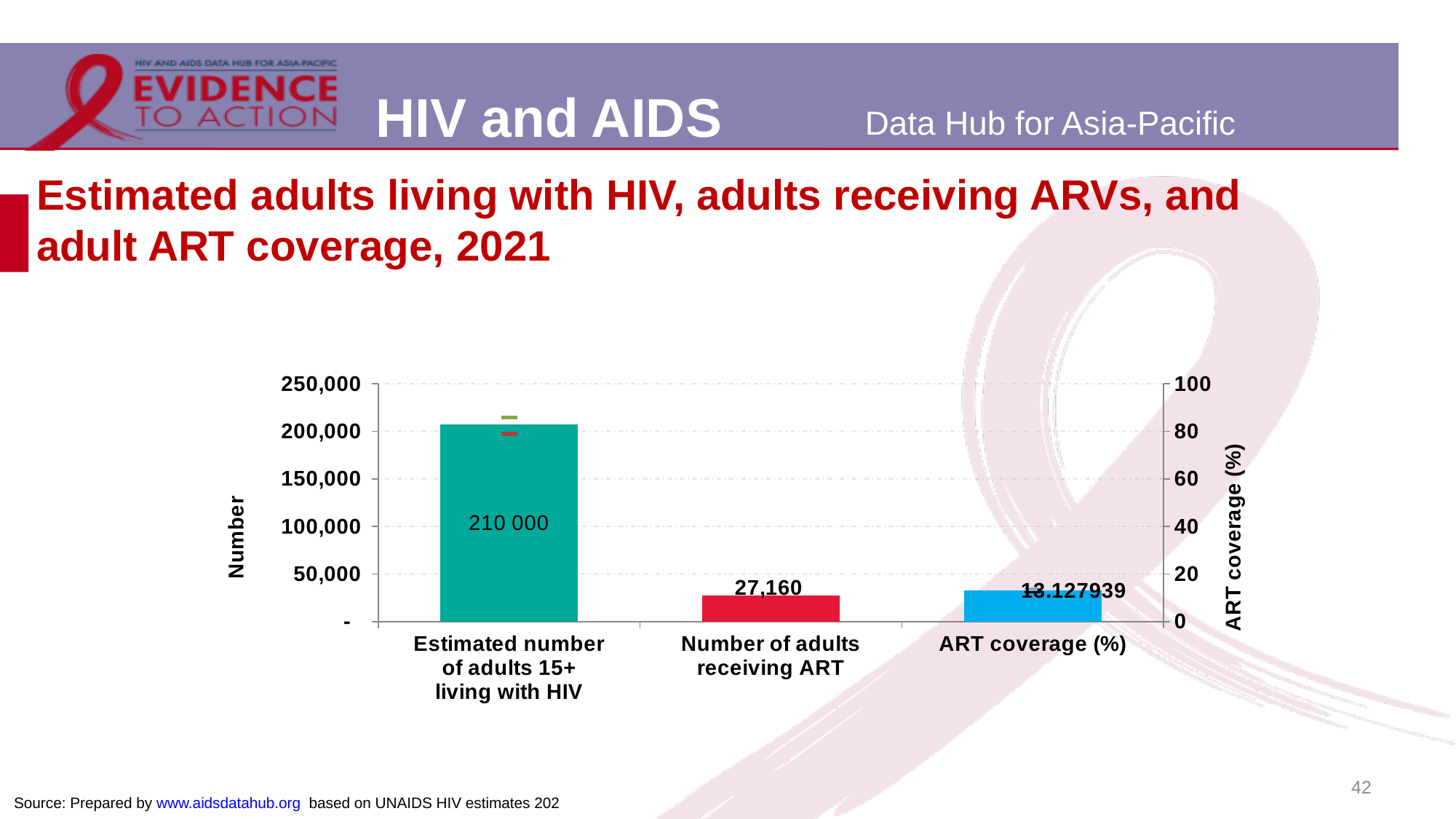
What is the title of the right vertical axis of the chart? ART coverage (%) What is the difference between the estimated number of adults 15+ living with HIV and the number of adults receiving ART? 182,840 How many categories are plotted on the chart? 3 Which category has the shortest bar on the chart? Number of adults receiving ART What is the estimated number of adults 15+ living with HIV shown on the chart? 210 000 What kind of chart is shown on the slide? bar chart What is the title of the left vertical axis of the chart? Number Is the number of adults receiving ART greater or less than 50,000? less Which category has the tallest bar on the chart? Estimated number of adults 15+ living with HIV On the right-hand axis, is the ART coverage (%) value greater or less than 20? less What is the number of adults receiving ART shown on the chart? 27,160 Which is larger: the estimated number of adults 15+ living with HIV or the number of adults receiving ART? Estimated number of adults 15+ living with HIV